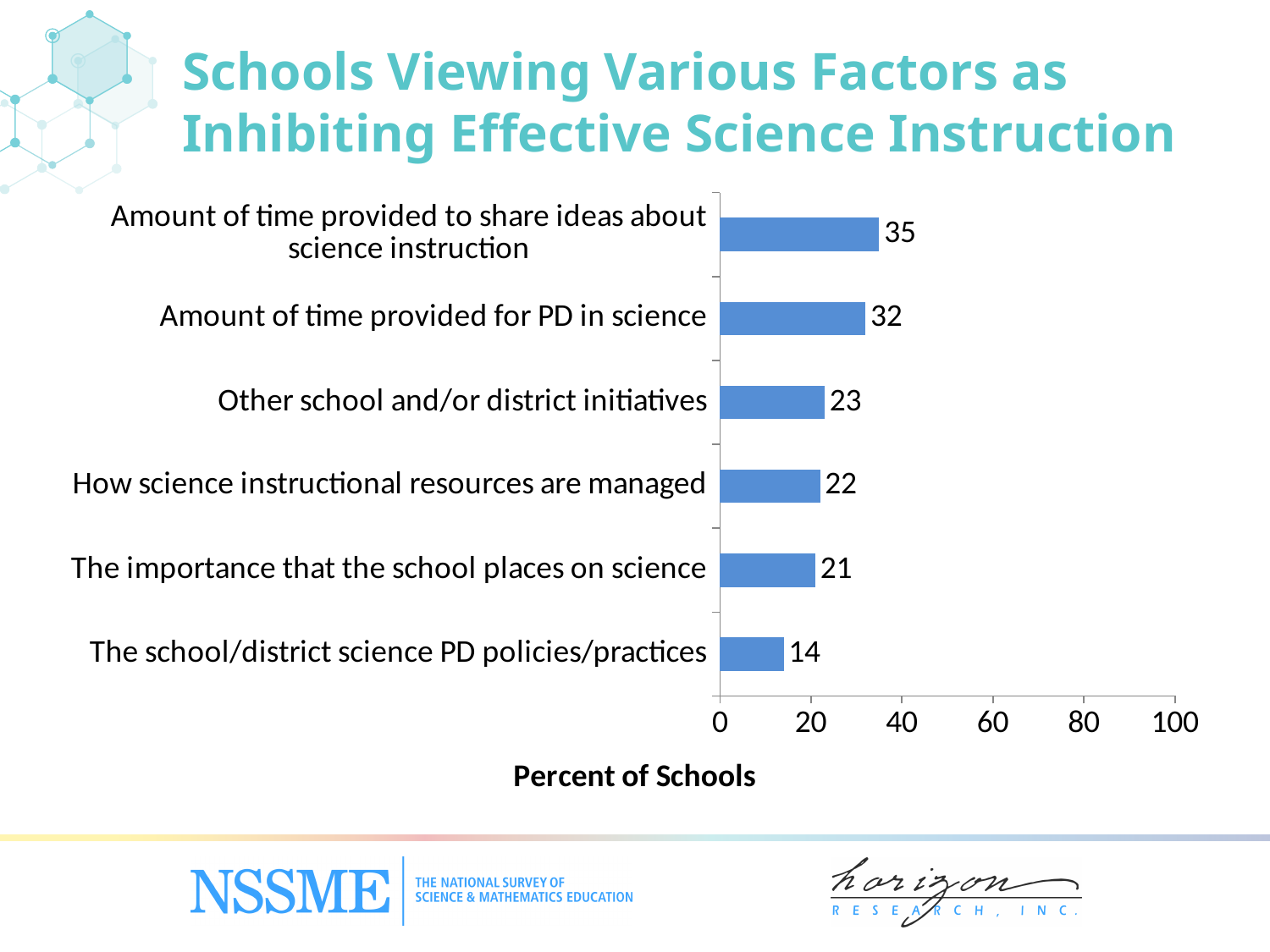
Which factor has the lowest percent of schools? The school/district science PD policies/practices Is the value for 'Other school and/or district initiatives' greater or less than 40? less Which factor has the highest percent of schools? Amount of time provided to share ideas about science instruction What is the difference between the highest and lowest values on the chart? 21 Which is larger: the value for 'Amount of time provided for PD in science' or 'How science instructional resources are managed'? Amount of time provided for PD in science What kind of chart is shown on the slide? bar chart How many factors are shown on the chart? 6 What percent of schools view the amount of time provided to share ideas about science instruction as inhibiting effective science instruction? 35 What is the value for 'Amount of time provided for PD in science'? 32 What is the difference between the values for 'Other school and/or district initiatives' and 'The importance that the school places on science'? 2 What is the value for 'The school/district science PD policies/practices'? 14 What is the label of the horizontal axis? Percent of Schools